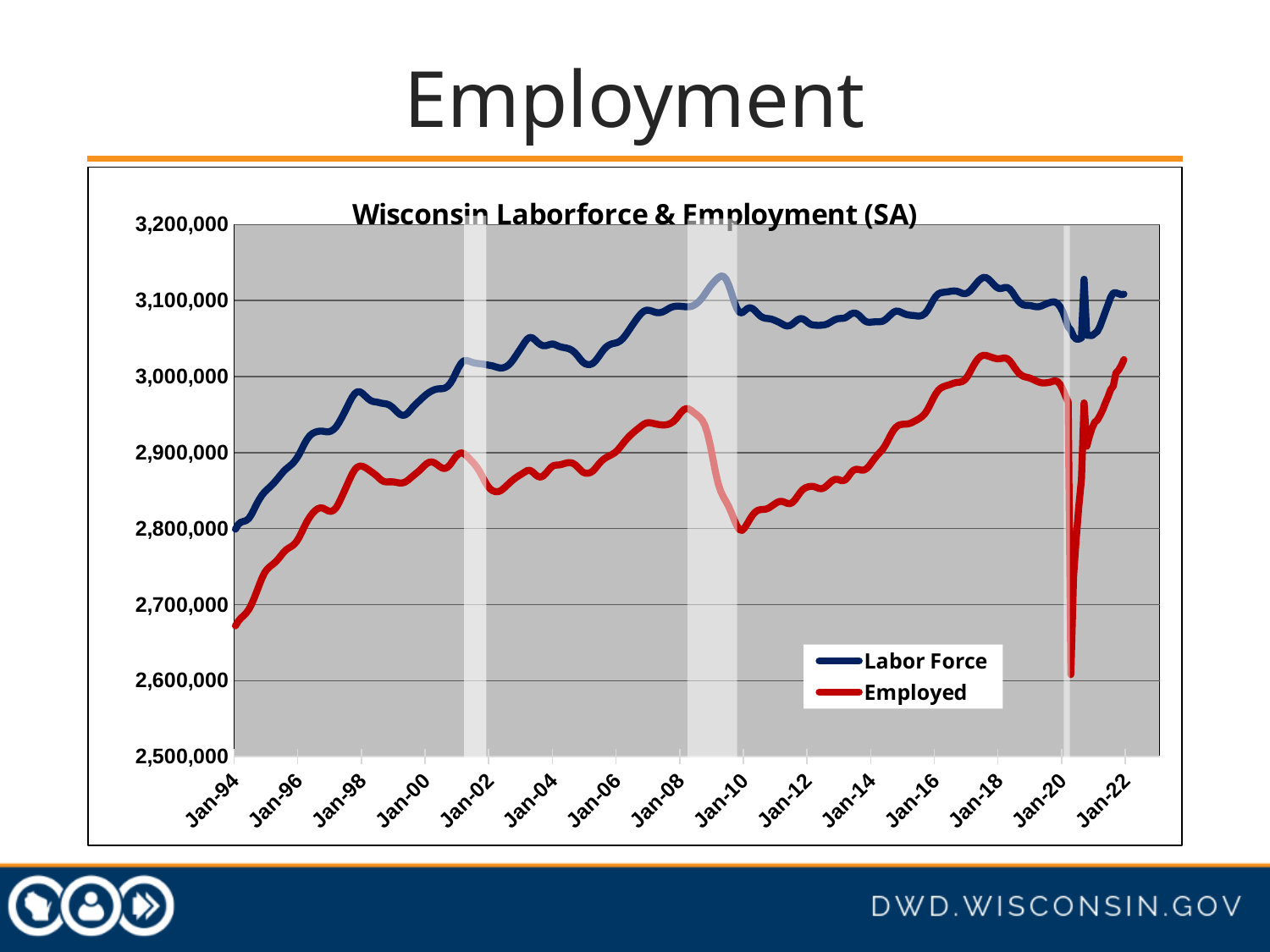
How many date labels are shown on the x axis? 15 Which series is drawn in red? Employed Is the Employed value at Jan-18 greater or less than 3,000,000? greater How many series does the legend list? 2 What kind of chart is shown on the slide? line chart Does the Employed series rise or fall between Jan-08 and Jan-10? fall Is the Employed value at Jan-94 greater or less than 2,700,000? less Is the Labor Force value at Jan-04 greater or less than 3,000,000? greater What is the title of the chart? Wisconsin Laborforce & Employment (SA) At Jan-10, which series has the higher value, Labor Force or Employed? Labor Force